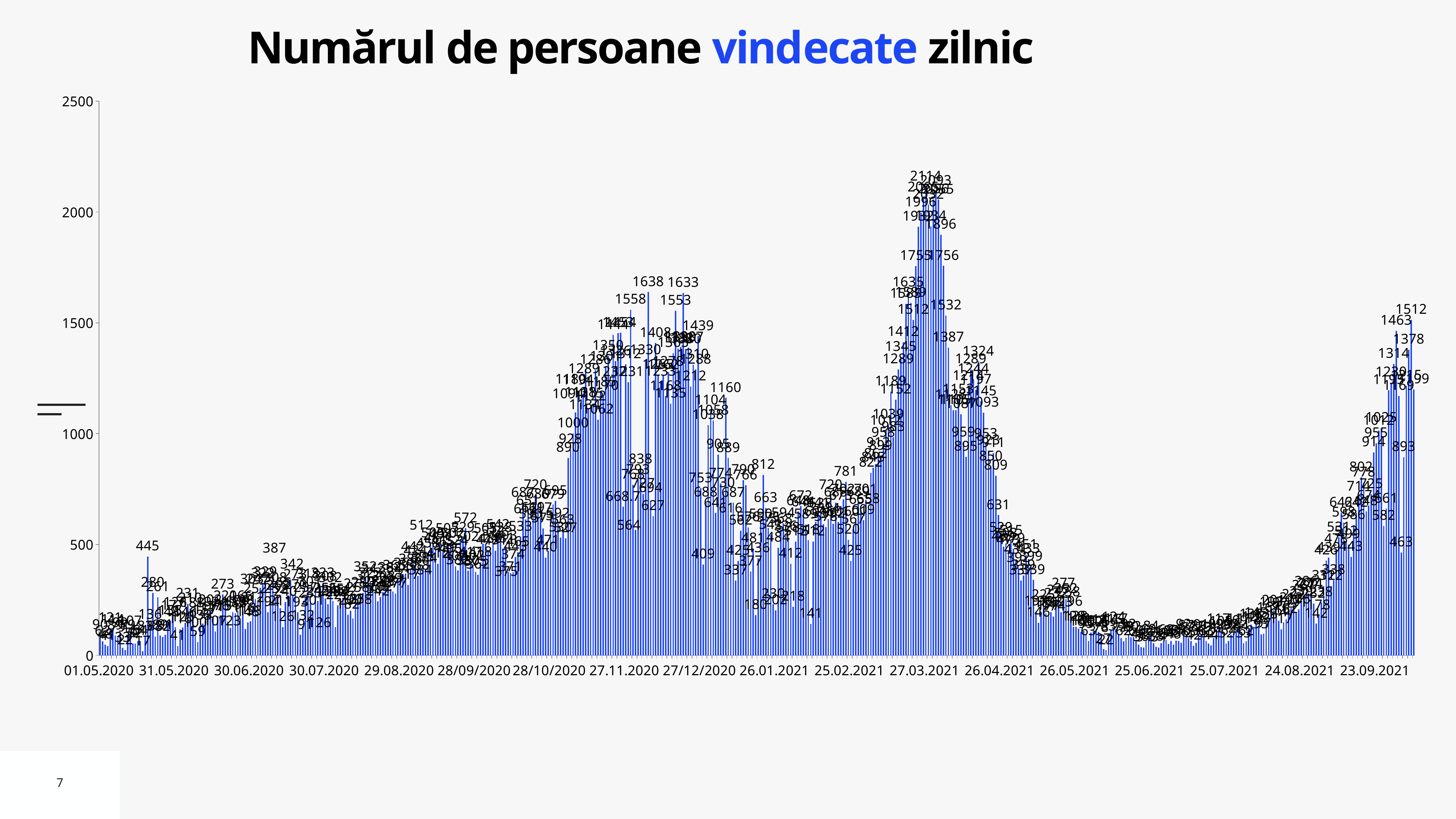
Are the values around 25.06.2021 greater or less than 500? less What is the highest tick value shown on the y axis? 2500 What kind of chart is shown on the slide? bar chart Do the values rise or fall along the x axis between 26.04.2021 and 25.06.2021? fall What is the difference between the peak value around 27.03.2021 (2114) and the peak value around 27.11.2020 (1638)? 476 What is the value labelled on the last bar at the right end of the chart? 1199 Around which x-axis date does the chart reach its highest peak? 27.03.2021 What is the title of the chart? Numărul de persoane vindecate zilnic What is the highest daily value labelled on the chart? 2114 Which peak is higher: the one around 27.03.2021 or the one around 27.11.2020? 27.03.2021 What is the highest value labelled at the peak around 27.11.2020? 1638 What is the value of the tallest bar in the first month of the chart (near 31.05.2020)? 445